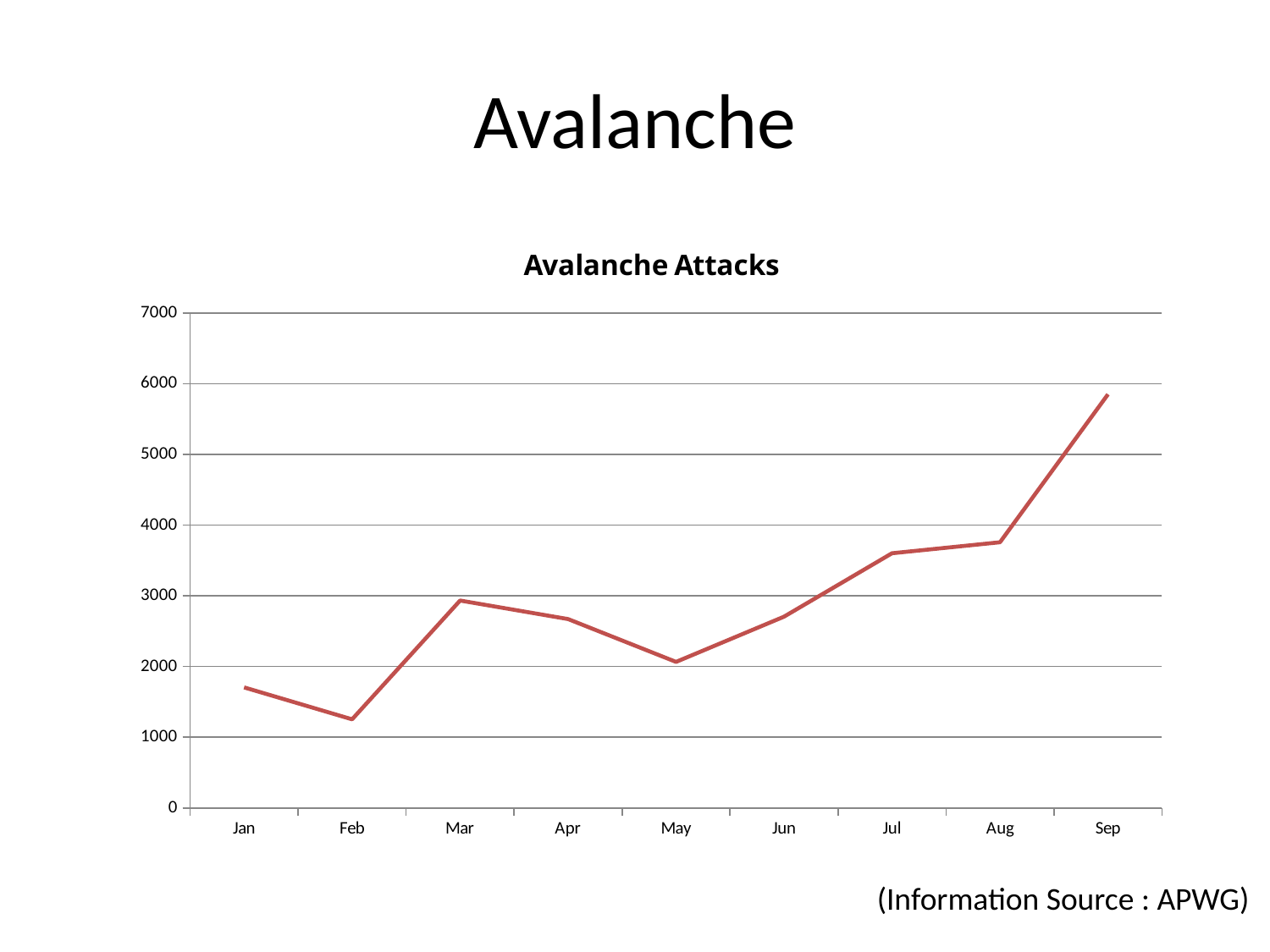
What type of chart is shown on the slide? line chart Do the values rise or fall from Jun to Sep? rise Is the value for Sep greater or less than 5000? greater What is the title of the chart? Avalanche Attacks How many months are plotted on the x axis? 9 Is the value for Feb greater or less than 2000? less Is the value for Jul greater or less than 3000? greater Which month has the highest number of Avalanche attacks? Sep Which month has a higher value, Aug or Jan? Aug Which month has a higher value, Mar or May? Mar Which month has the lowest number of Avalanche attacks? Feb